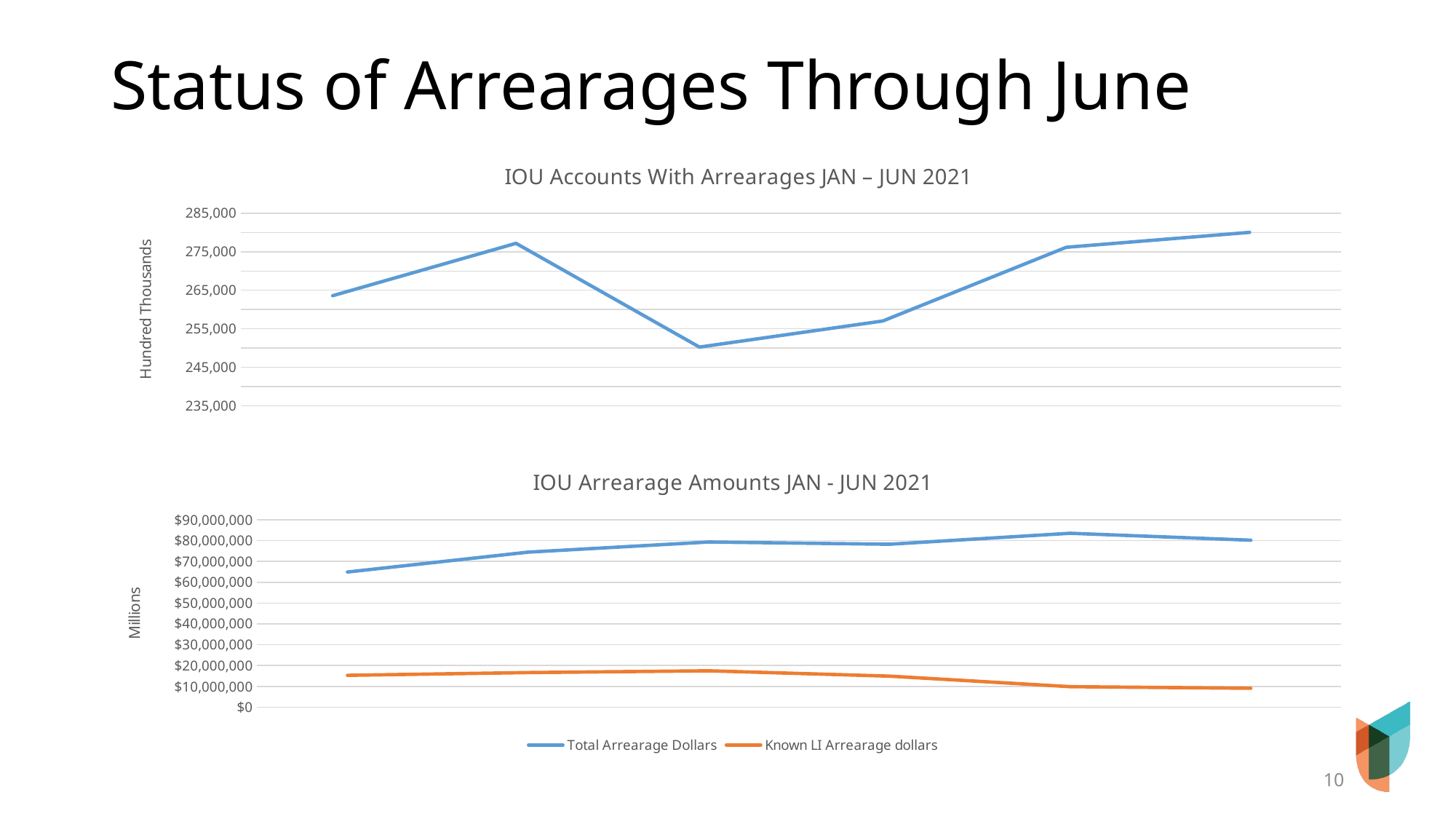
How many series does the legend of the bottom chart, 'IOU Arrearage Amounts JAN - JUN 2021', list? 2 In the top chart, 'IOU Accounts With Arrearages JAN – JUN 2021', is the highest point on the line greater or less than 275,000? greater What kind of chart is the bottom chart, 'IOU Arrearage Amounts JAN - JUN 2021'? Line chart In the bottom chart, 'IOU Arrearage Amounts JAN - JUN 2021', is the highest point of the Known LI Arrearage dollars line greater or less than $20,000,000? less In the bottom chart, 'IOU Arrearage Amounts JAN - JUN 2021', which series is plotted higher throughout: Total Arrearage Dollars or Known LI Arrearage dollars? Total Arrearage Dollars In the top chart, 'IOU Accounts With Arrearages JAN – JUN 2021', does the line rise or fall over the last three points? Rise How many data points does the line in the top chart, 'IOU Accounts With Arrearages JAN – JUN 2021', have? 6 What kind of chart is the top chart, 'IOU Accounts With Arrearages JAN – JUN 2021'? Line chart In the bottom chart, 'IOU Arrearage Amounts JAN - JUN 2021', is the lowest point of the Total Arrearage Dollars line greater or less than $60,000,000? greater In the bottom chart, 'IOU Arrearage Amounts JAN - JUN 2021', does the Known LI Arrearage dollars line rise or fall over the last three points? Fall What is the vertical axis label of the top chart, 'IOU Accounts With Arrearages JAN – JUN 2021'? Hundred Thousands